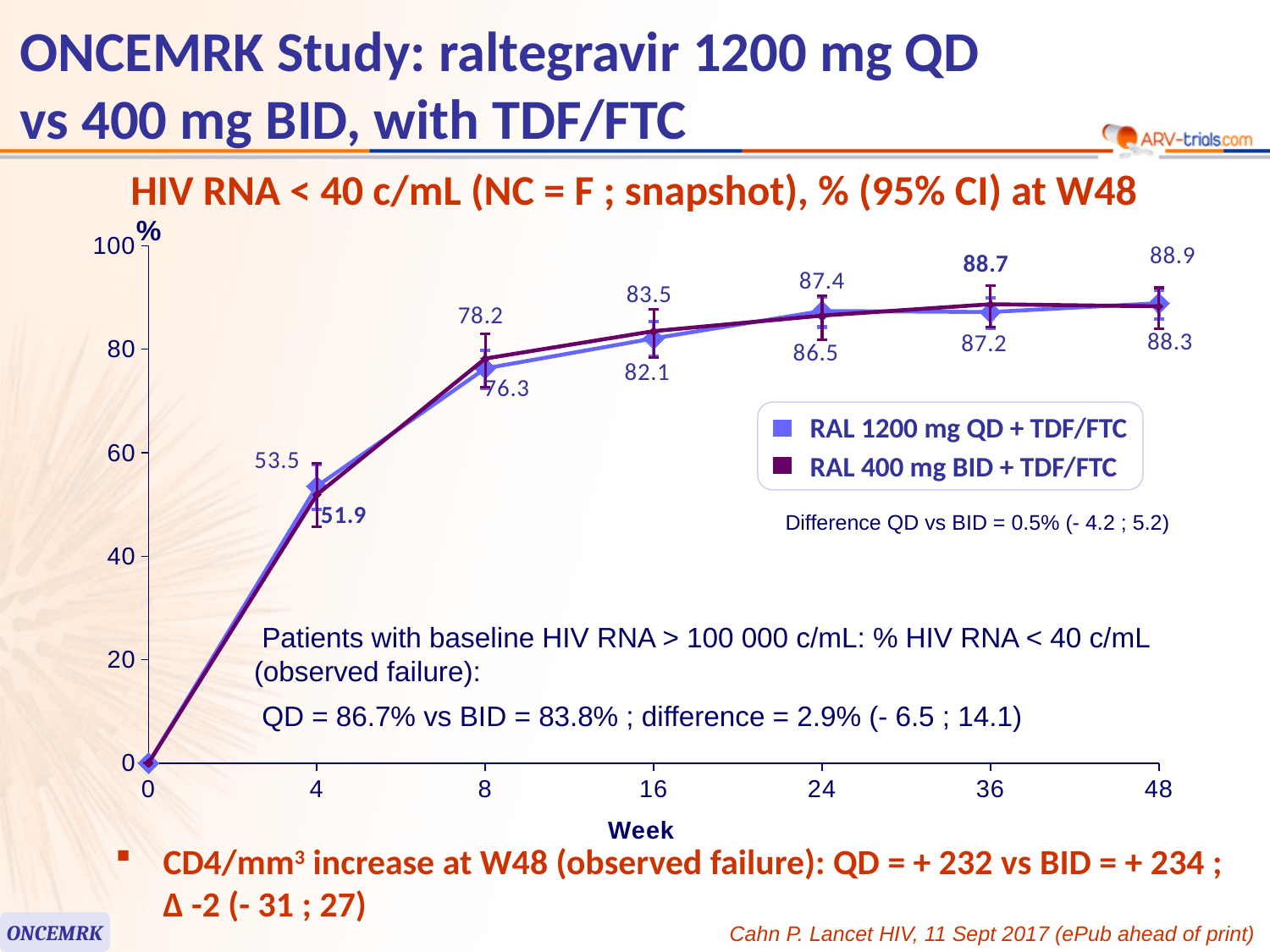
What is the value for RAL 1200 mg QD + TDF/FTC at week 4? 53.5 How many week time points are marked on the x axis? 7 What kind of chart is shown on the slide? Line chart What is the difference between the QD and BID values at week 4? 1.6 What is the value for RAL 400 mg BID + TDF/FTC at week 36? 88.7 What is the value for RAL 1200 mg QD + TDF/FTC at week 48? 88.9 What is the higher of the two values labelled at week 16? 83.5 What is the value for RAL 400 mg BID + TDF/FTC at week 4? 51.9 What is the value for RAL 400 mg BID + TDF/FTC at week 48? 88.3 Are the values at week 8 greater or less than 60? Greater How many series does the legend list? 2 Do the values rise or fall from week 0 to week 48? Rise